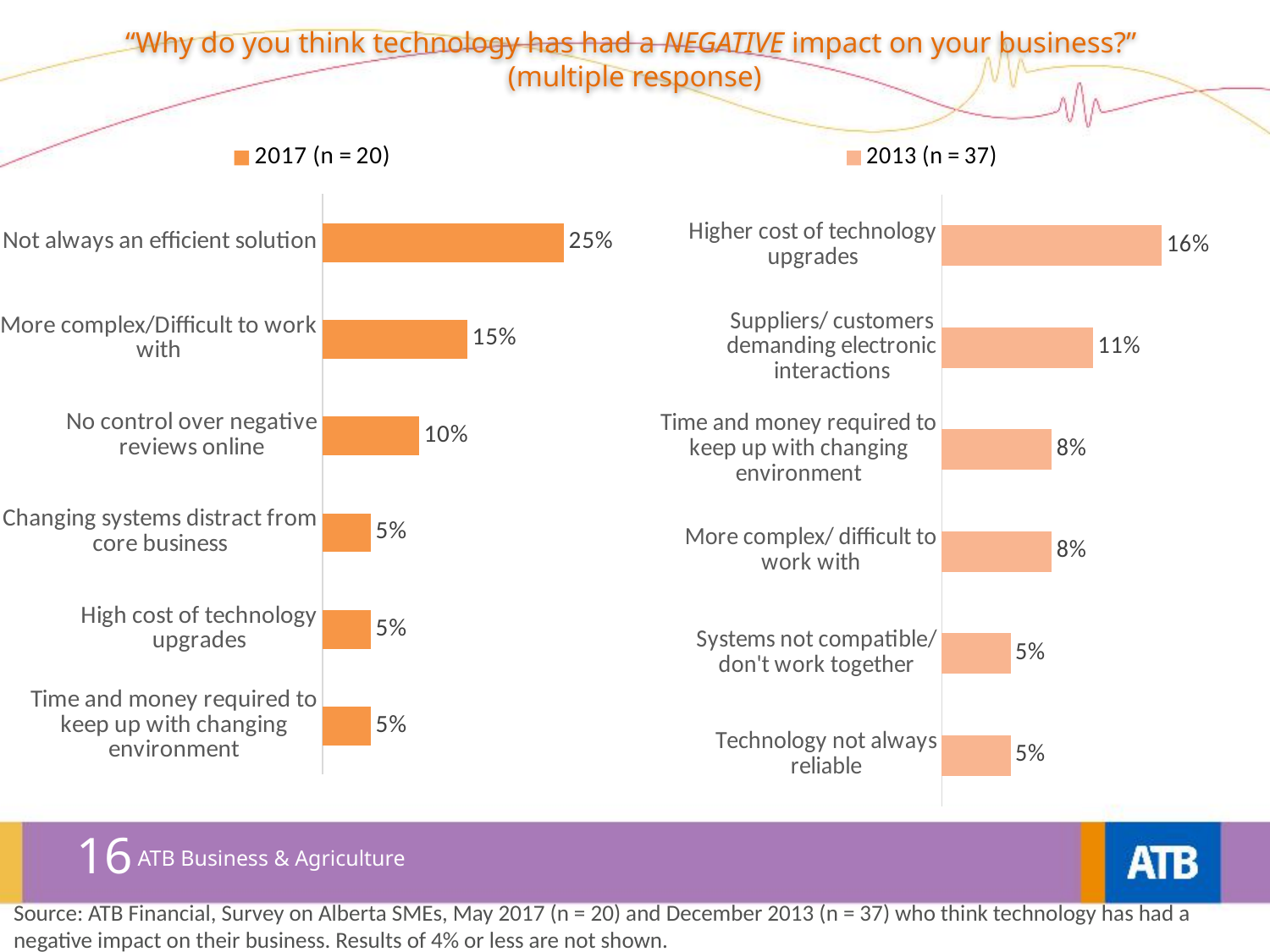
In the 2017 (n = 20) chart, what percentage is shown for "No control over negative reviews online"? 10% Which is larger: "More complex/Difficult to work with" in the 2017 chart or "More complex/ difficult to work with" in the 2013 chart? 2017 chart (15%) In the 2017 (n = 20) chart, what is the difference between "Not always an efficient solution" and "More complex/Difficult to work with"? 10% In the 2013 (n = 37) chart, what percentage is shown for "Suppliers/ customers demanding electronic interactions"? 11% How many categories are shown in the 2013 (n = 37) chart? 6 In the 2017 (n = 20) chart, what percentage is shown for "Not always an efficient solution"? 25% In the 2017 (n = 20) chart, which category has the highest value? Not always an efficient solution How many categories are shown in the 2017 (n = 20) chart? 6 In the 2013 (n = 37) chart, what percentage is shown for "Higher cost of technology upgrades"? 16% In the 2013 (n = 37) chart, what is the difference between "Higher cost of technology upgrades" and "Systems not compatible/ don't work together"? 11% What type of chart is used on this slide? Bar chart In the 2013 (n = 37) chart, which category has the highest value? Higher cost of technology upgrades